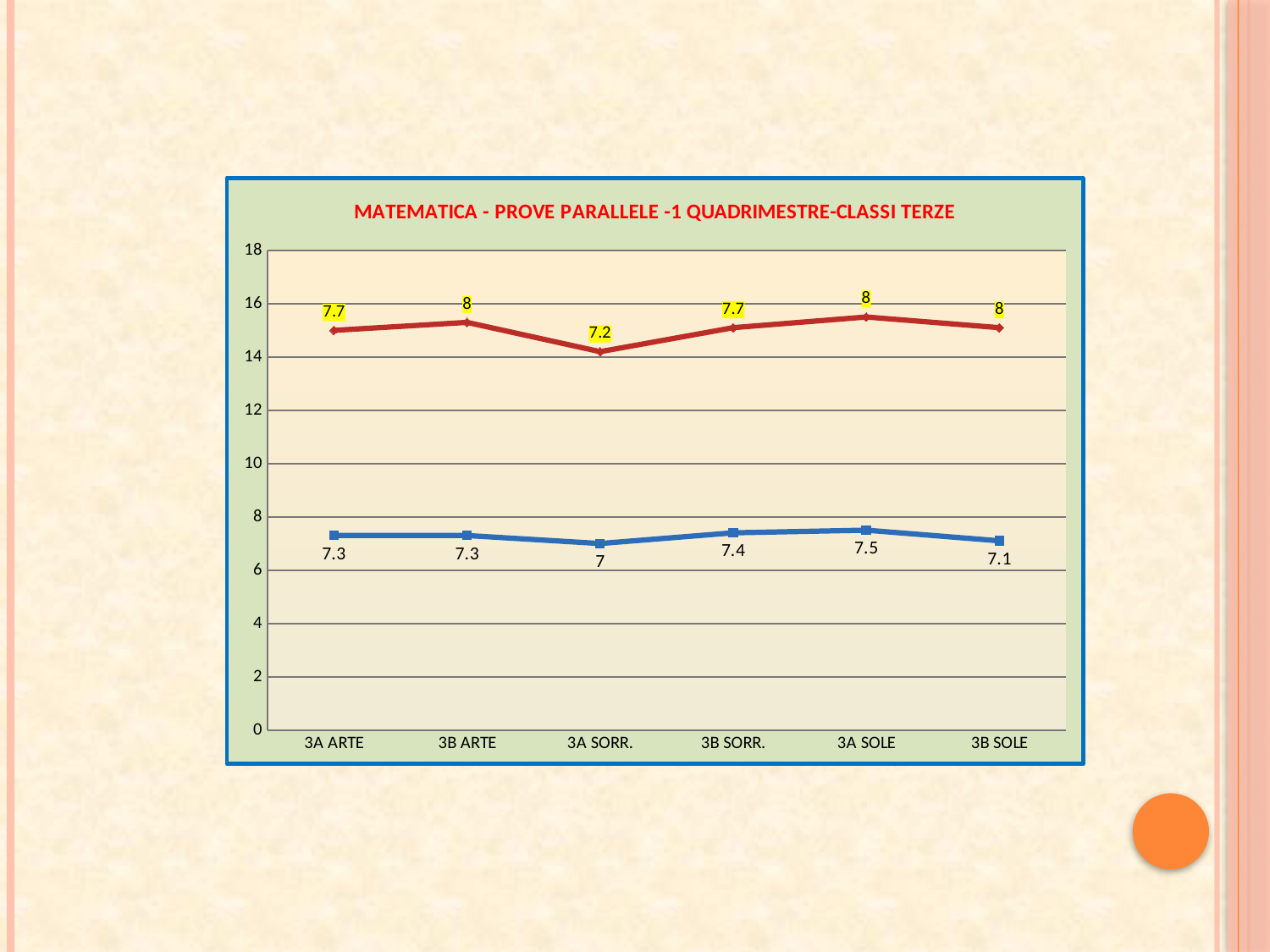
What is the title of the chart? MATEMATICA - PROVE PARALLELE -1 QUADRIMESTRE-CLASSI TERZE What is the value labelled on the red line for 3A SORR.? 7.2 What kind of chart is shown on the slide? line chart On the blue line, which labelled value is larger: 3B SORR. or 3B SOLE? 3B SORR. Which category has the highest labelled value on the blue line? 3A SOLE Which category has the lowest labelled value on the blue line? 3A SORR. What is the value labelled on the blue line for 3A SORR.? 7 What is the value labelled on the blue line for 3B SOLE? 7.1 What is the value labelled on the red line for 3B SORR.? 7.7 Which category has the lowest labelled value on the red line? 3A SORR. How many categories are shown on the x axis? 6 What is the difference between the blue line's labelled values for 3A SOLE and 3B SOLE? 0.4